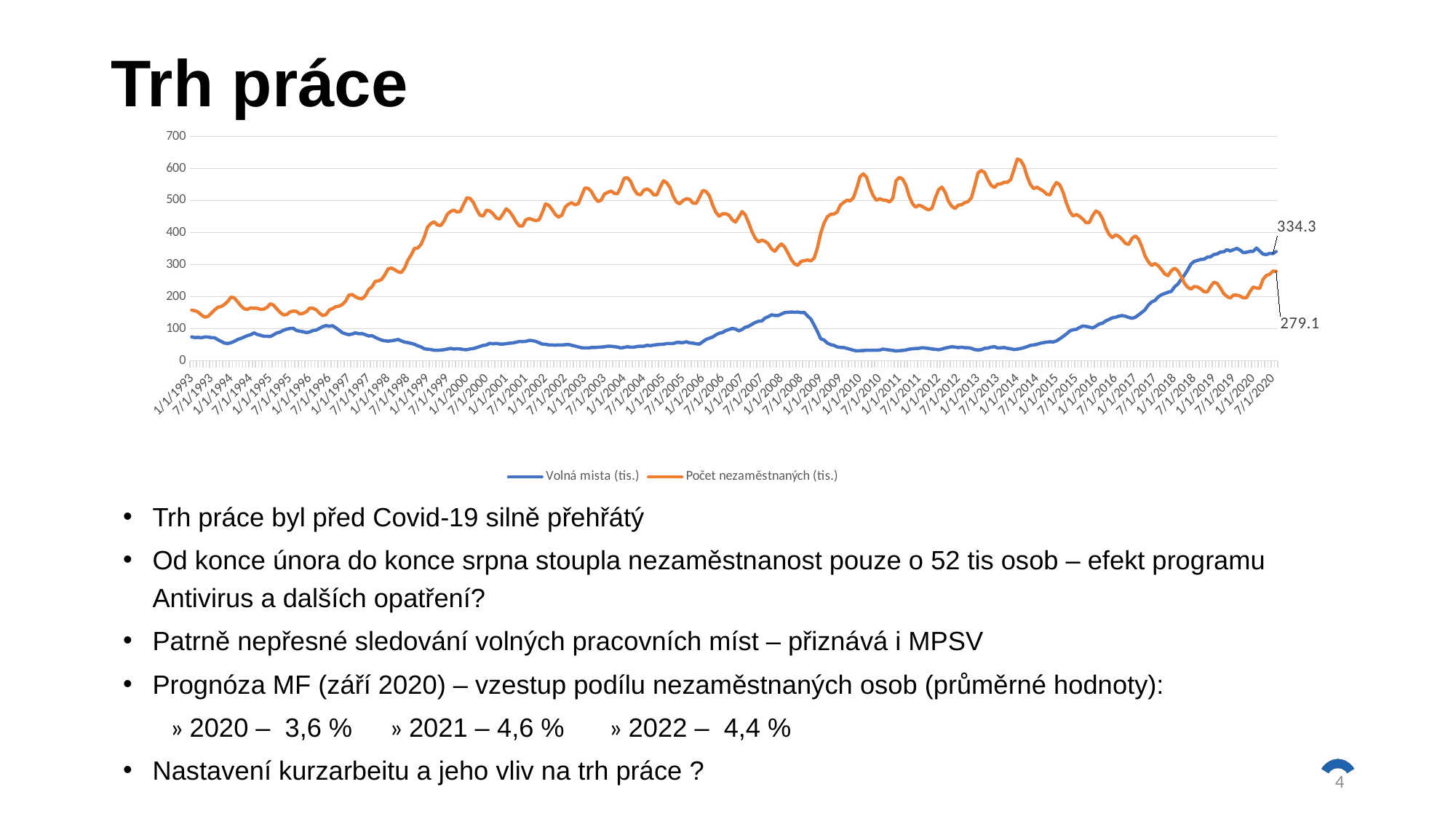
Does the Volná místa (tis.) series rise or fall between 1/1/2017 and 1/1/2020? rise What is the labelled final value of the Volná místa (tis.) series? 334.3 What kind of chart is shown on the slide? line chart What is the difference between the final labelled values of Volná místa (tis.) and Počet nezaměstnaných (tis.)? 55.2 How many series does the chart's legend list? 2 Does the Počet nezaměstnaných (tis.) series rise or fall between 1/1/2014 and 1/1/2019? fall What colour is the line for Volná místa (tis.)? blue Is the value of Počet nezaměstnaných (tis.) around 1/1/2014 greater or less than 500? greater What is the labelled final value of the Počet nezaměstnaných (tis.) series? 279.1 At the last point on the chart, which series has the larger value, Volná místa (tis.) or Počet nezaměstnaných (tis.)? Volná místa (tis.) Which series reaches the higher peak value over the whole period, Volná místa (tis.) or Počet nezaměstnaných (tis.)? Počet nezaměstnaných (tis.) Is the value of Volná místa (tis.) around 1/1/2010 greater or less than 100? less